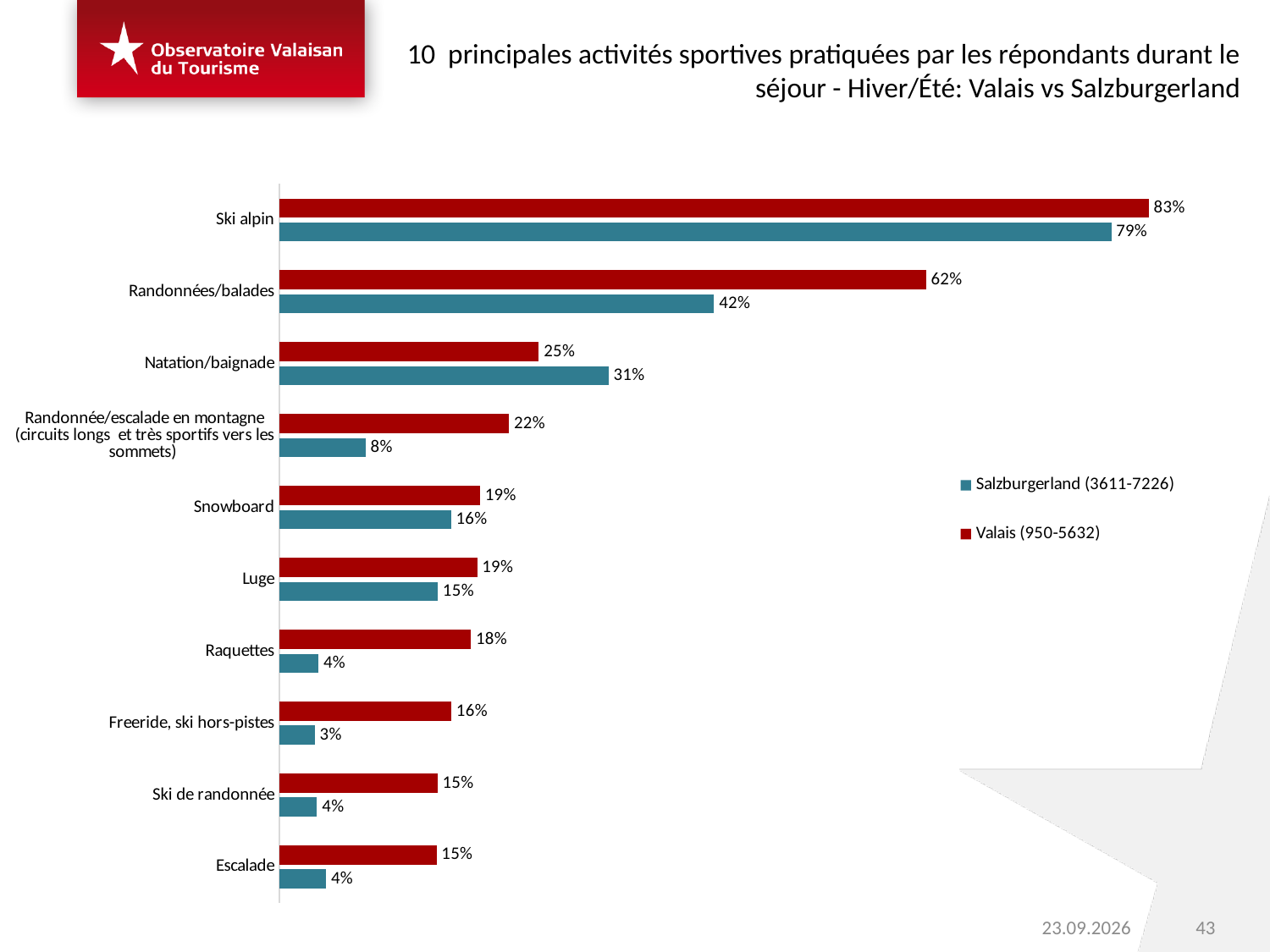
Which activity has the lowest value for Salzburgerland (3611-7226)? Freeride, ski hors-pistes What kind of chart is shown on the slide? Bar chart What is the value for Salzburgerland (3611-7226) for Freeride, ski hors-pistes? 3% How many series does the legend list? 2 How many activities are shown on the chart? 10 What is the difference between the Valais and Salzburgerland values for Raquettes? 14% What is the value for Salzburgerland (3611-7226) for Natation/baignade? 31% What is the value for Valais (950-5632) for Ski alpin? 83% What is the difference between the Valais and Salzburgerland values for Randonnées/balades? 20% For Natation/baignade, which series has the larger value, Valais (950-5632) or Salzburgerland (3611-7226)? Salzburgerland (3611-7226) Which activity has the highest value for Valais (950-5632)? Ski alpin Which colour represents Valais (950-5632) in the chart? Red